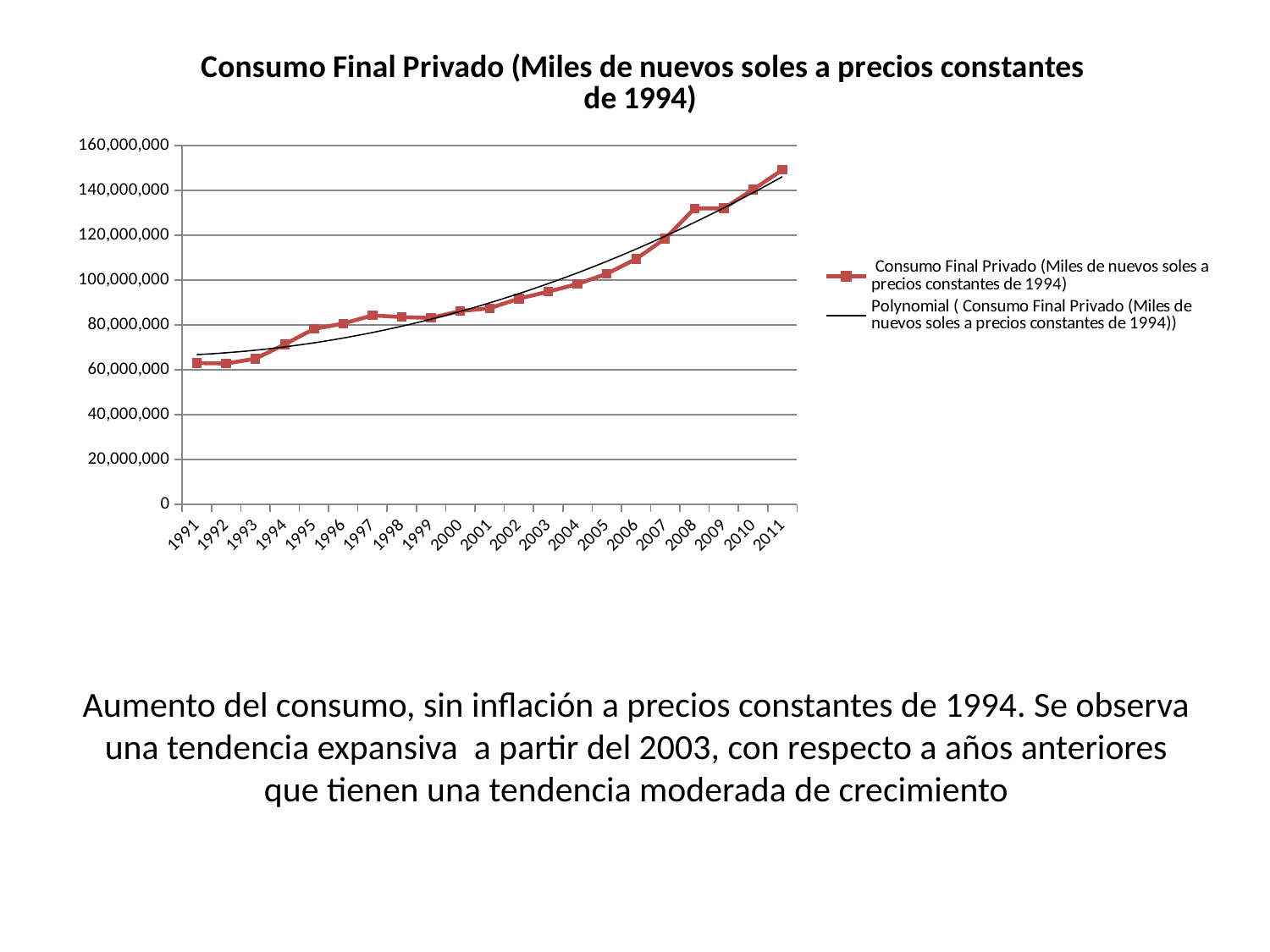
Do the values of Consumo Final Privado generally rise or fall from 1991 to 2011? rise How many entries does the legend list? 2 Is the value for 2003 greater or less than 100,000,000? less How many years are plotted along the x axis? 21 Is the value for 2008 greater or less than 120,000,000? greater Which year has the larger value, 2003 or 2007? 2007 What kind of chart is shown on the slide? line chart Is the value for 1991 greater or less than 80,000,000? less Which year has the highest value of Consumo Final Privado? 2011 What is the title of the chart? Consumo Final Privado (Miles de nuevos soles a precios constantes de 1994)